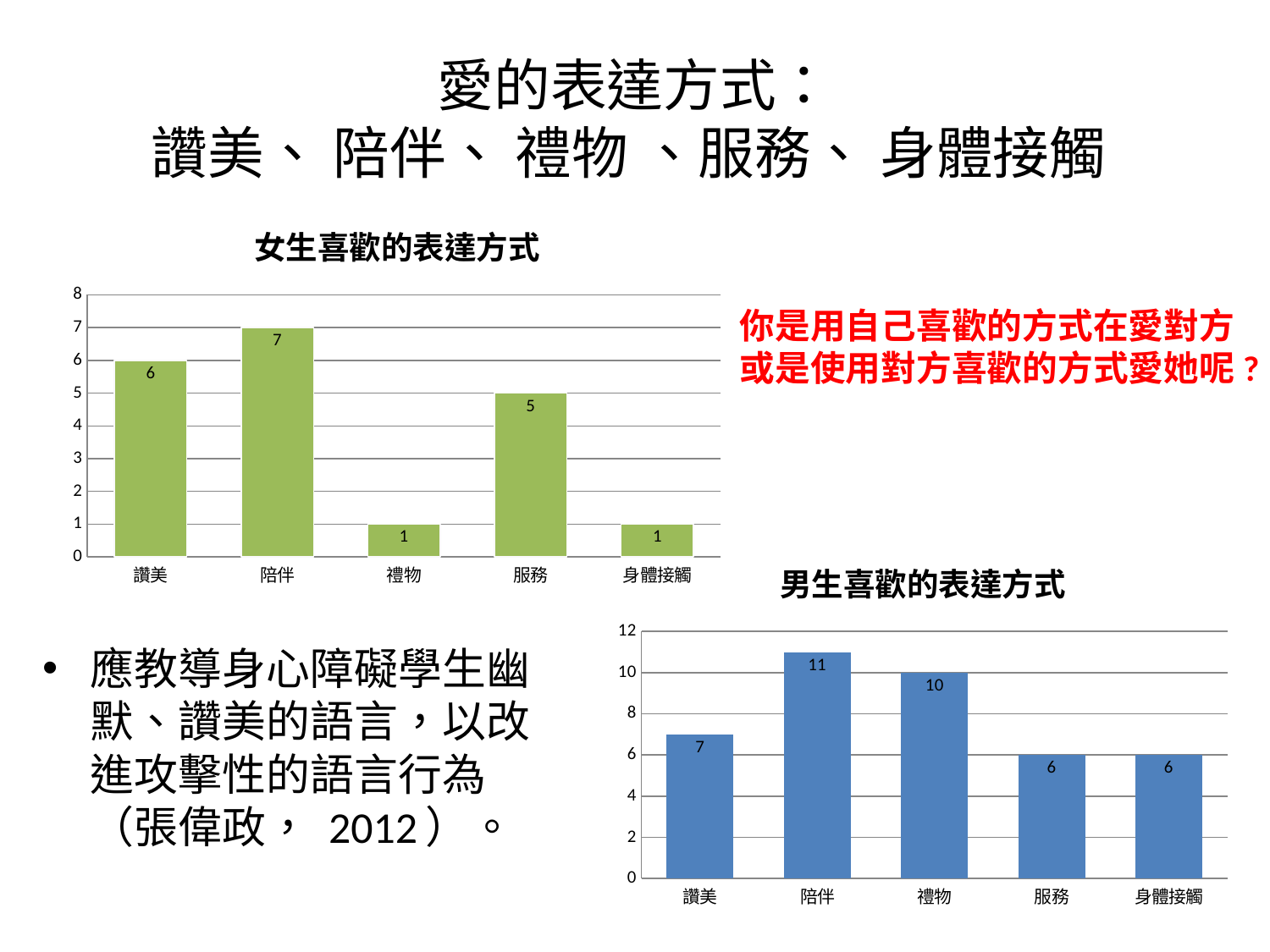
What is the title of the chart in the upper left of the slide? 女生喜歡的表達方式 In the 女生喜歡的表達方式 chart, what is the value for 禮物? 1 In the 女生喜歡的表達方式 chart, what is the value for 陪伴? 7 In the 男生喜歡的表達方式 chart, what is the difference between 陪伴 and 讚美? 4 In the 男生喜歡的表達方式 chart, what is the value for 服務? 6 In the 女生喜歡的表達方式 chart, what is the difference between 讚美 and 服務? 1 In the 女生喜歡的表達方式 chart, how many categories are shown? 5 In the 男生喜歡的表達方式 chart, what is the value for 禮物? 10 In the 女生喜歡的表達方式 chart, which category has the highest value? 陪伴 In the 男生喜歡的表達方式 chart, which category has the highest value? 陪伴 In the 男生喜歡的表達方式 chart, which is larger, 讚美 or 禮物? 禮物 What type of chart is the 男生喜歡的表達方式 chart? Bar chart